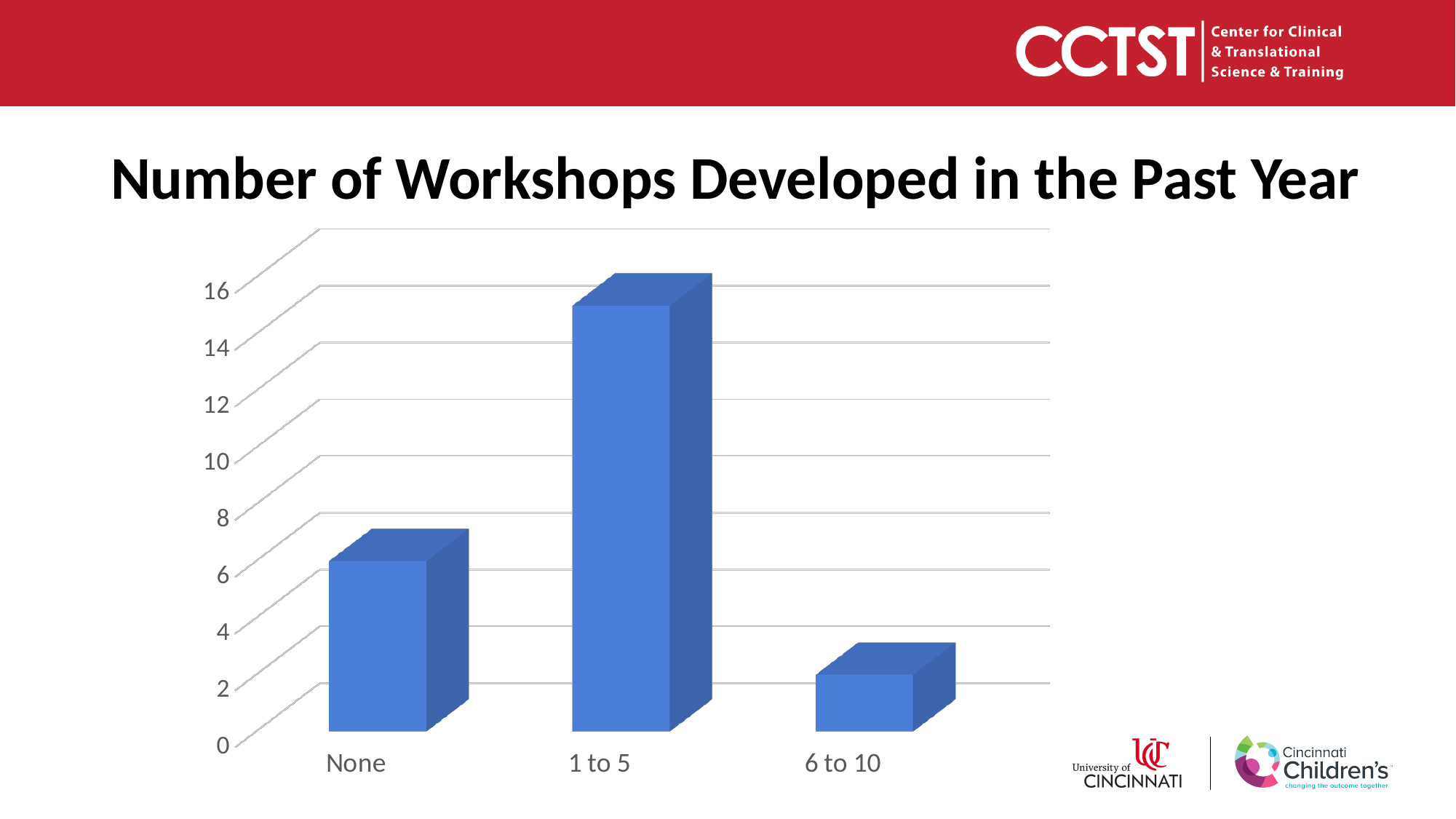
Is the value for None greater or less than 4? greater Which is larger, the value for None or the value for 6 to 10? None What kind of chart is shown on the slide? bar chart Which category has the highest value? 1 to 5 Which category has the lowest value? 6 to 10 What colour are the bars in the chart? blue Does the value rise or fall from the 1 to 5 category to the 6 to 10 category? fall Is the value for 6 to 10 greater or less than 4? less How many categories are shown on the x axis of the chart? 3 Is the value for None greater or less than 8? less What is the title of the chart? Number of Workshops Developed in the Past Year